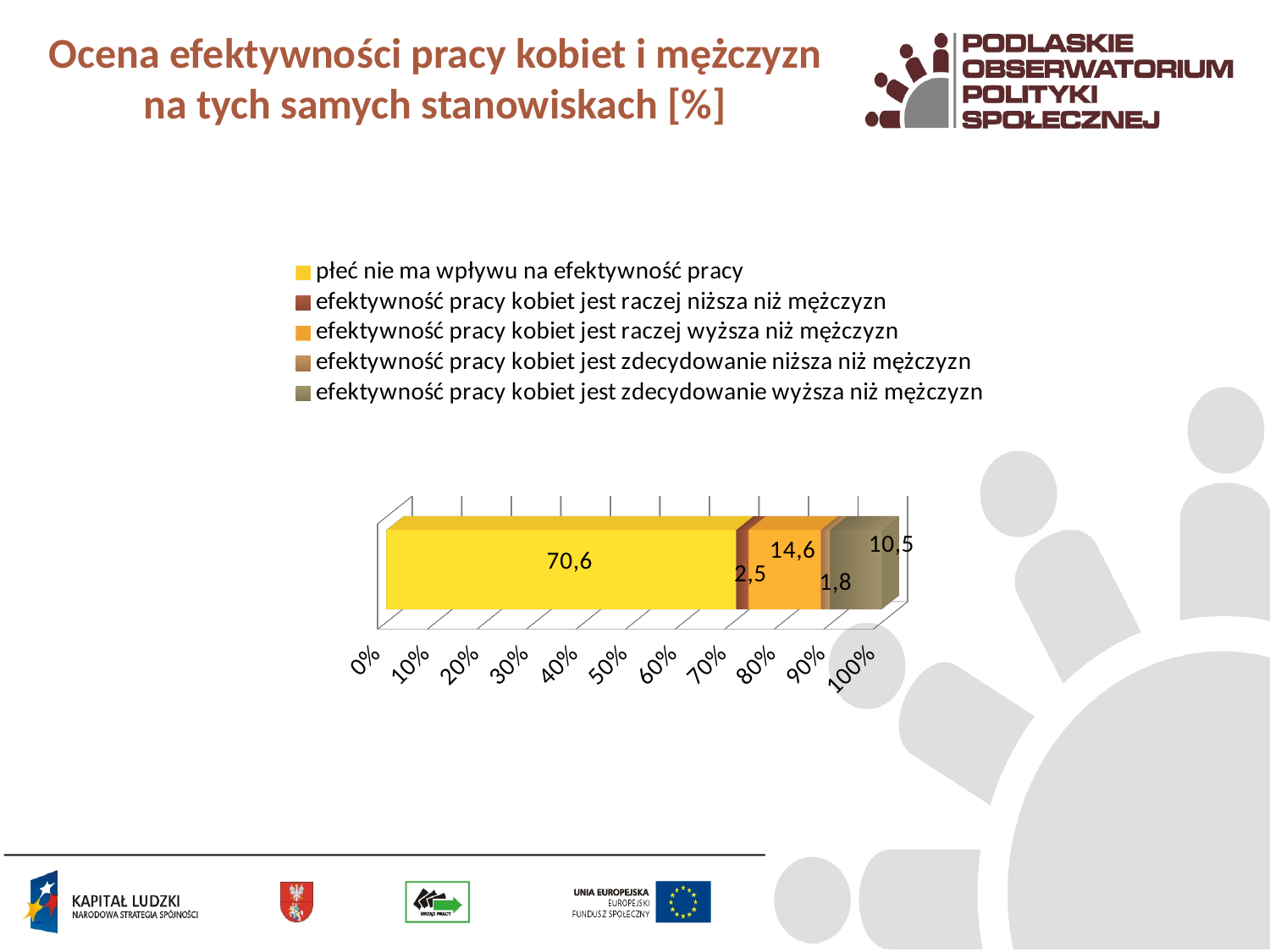
Which response has the smallest share in the bar? efektywność pracy kobiet jest zdecydowanie niższa niż mężczyzn How many series does the legend list? 5 What is the value for 'efektywność pracy kobiet jest zdecydowanie wyższa niż mężczyzn'? 10,5 What kind of chart is shown on the slide? stacked bar chart What is the difference between the share for 'raczej wyższa' (14,6) and 'zdecydowanie wyższa' (10,5)? 4,1 Which response has the largest share in the bar? płeć nie ma wpływu na efektywność pracy What is the value for 'efektywność pracy kobiet jest raczej wyższa niż mężczyzn'? 14,6 What is the total of all segments in the stacked bar? 100,0 What is the value for 'efektywność pracy kobiet jest raczej niższa niż mężczyzn'? 2,5 What percentage of respondents said that gender has no influence on work effectiveness (płeć nie ma wpływu na efektywność pracy)? 70,6 Which is larger: the share for 'raczej niższa' or the share for 'zdecydowanie niższa'? raczej niższa What is the title of the chart on the slide? Ocena efektywności pracy kobiet i mężczyzn na tych samych stanowiskach [%]